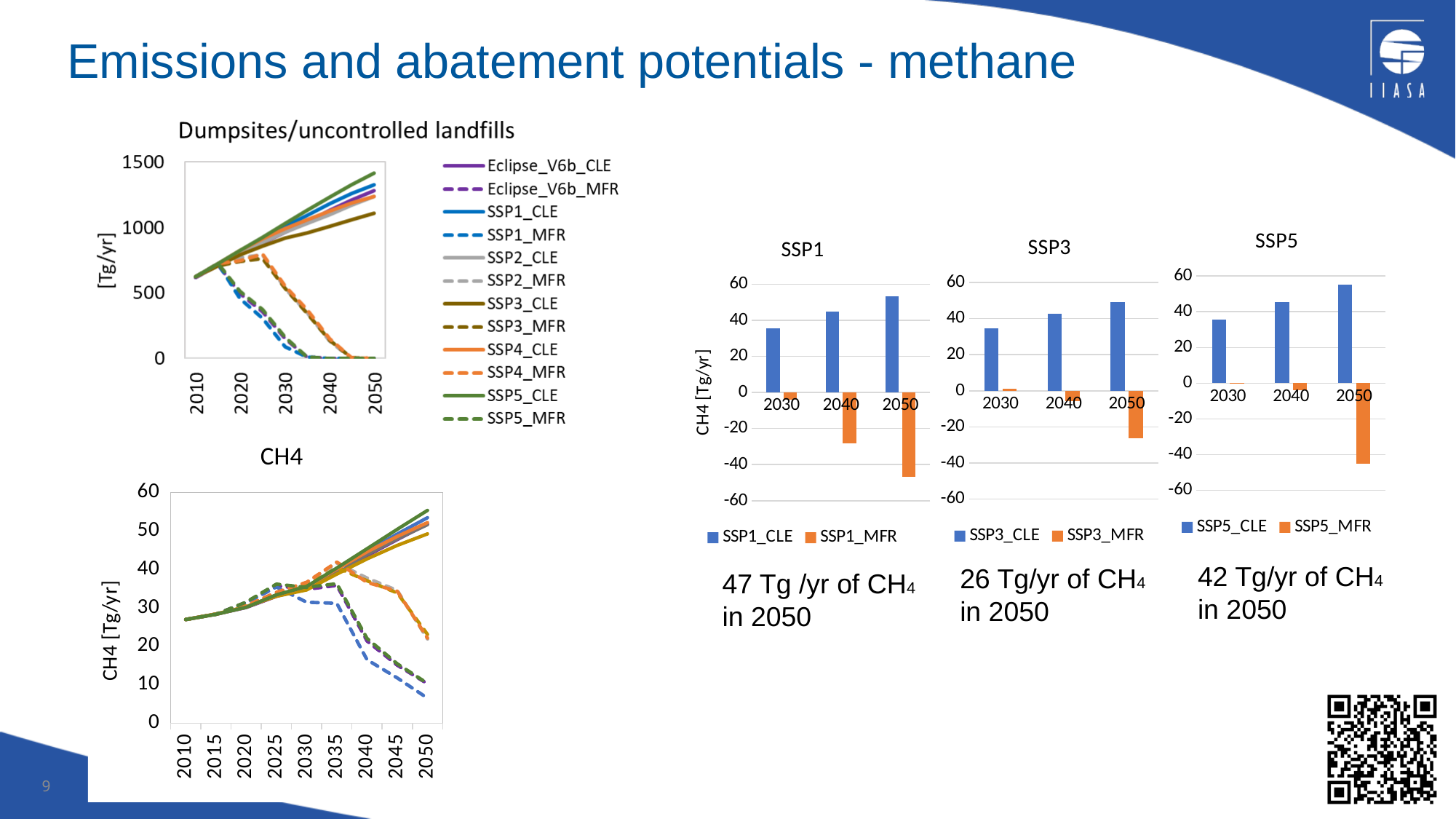
What kind of chart is the 'Dumpsites/uncontrolled landfills' chart? line chart In the SSP5 chart, which year has the highest SSP5_CLE value? 2050 What unit is shown on the y axis of the 'Dumpsites/uncontrolled landfills' chart? [Tg/yr] In the SSP3 chart, which is larger: the SSP3_CLE value for 2030 or for 2050? 2050 How many series does the legend of the SSP1 chart list? 2 In the 'Dumpsites/uncontrolled landfills' chart, is the SSP5_CLE value in 2050 greater or less than 1000? greater How many years are shown on the x axis of the SSP3 chart? 3 In the SSP1 chart, is the SSP1_CLE value for 2050 greater or less than 40? greater In the SSP1 chart, is the SSP1_MFR value for 2050 greater or less than -40? less What kind of chart is the SSP1 chart on the right? bar chart In the SSP5 chart, do the SSP5_CLE values rise or fall from 2030 to 2050? rise How many series does the legend of the 'Dumpsites/uncontrolled landfills' chart list? 12